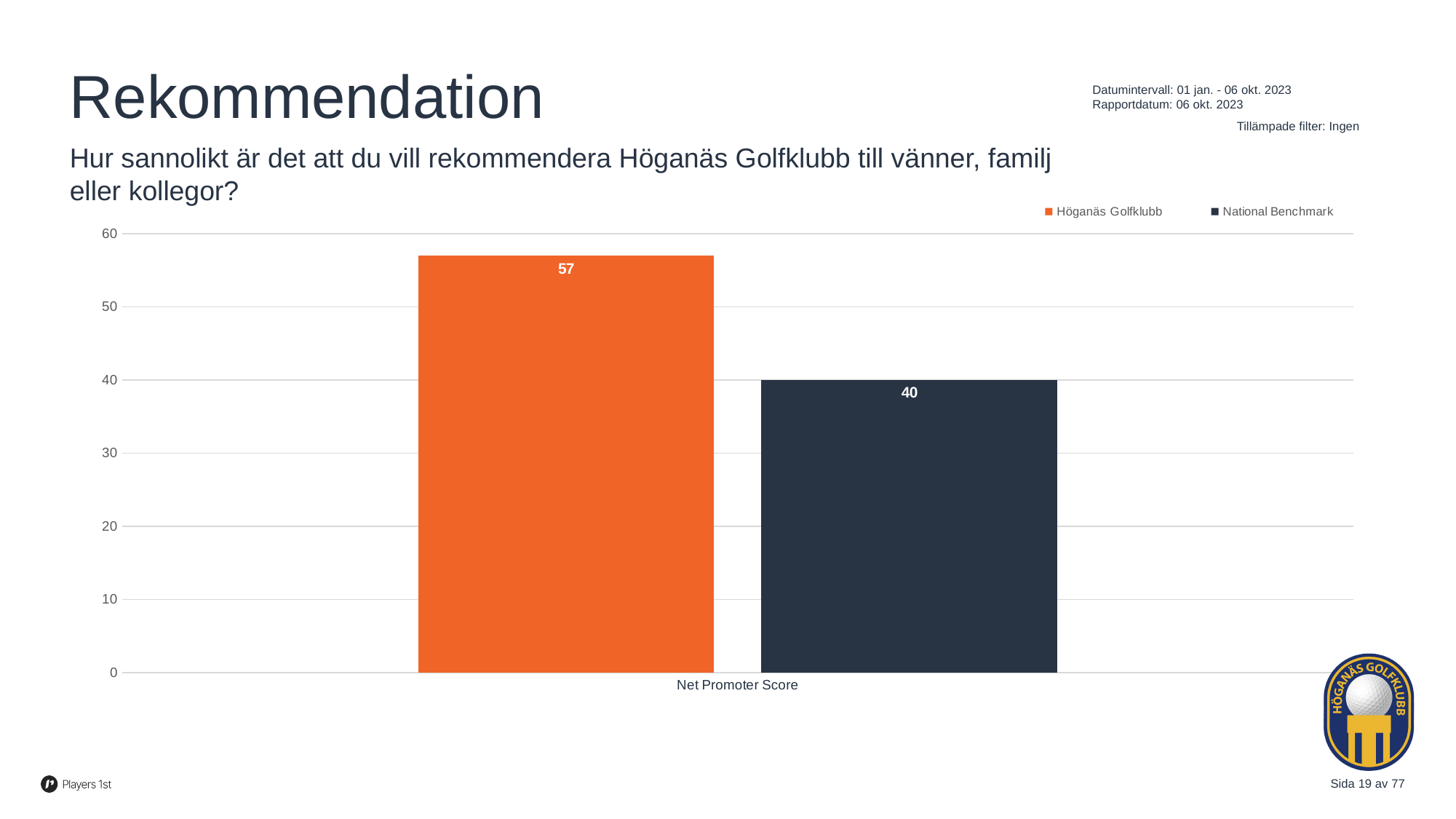
Is the value for National Benchmark greater or less than 50? less Is the value for Höganäs Golfklubb greater or less than 50? greater Which series has the higher Net Promoter Score? Höganäs Golfklubb What is the Net Promoter Score for the National Benchmark? 40 How many series does the legend list? 2 What is the Net Promoter Score for Höganäs Golfklubb? 57 Which series has the lower Net Promoter Score? National Benchmark What colour is the bar for Höganäs Golfklubb? orange What is the difference between the Höganäs Golfklubb score and the National Benchmark score? 17 What kind of chart is shown on the slide? bar chart Is the Höganäs Golfklubb score larger or smaller than the National Benchmark score? larger What is the label on the x axis of the chart? Net Promoter Score